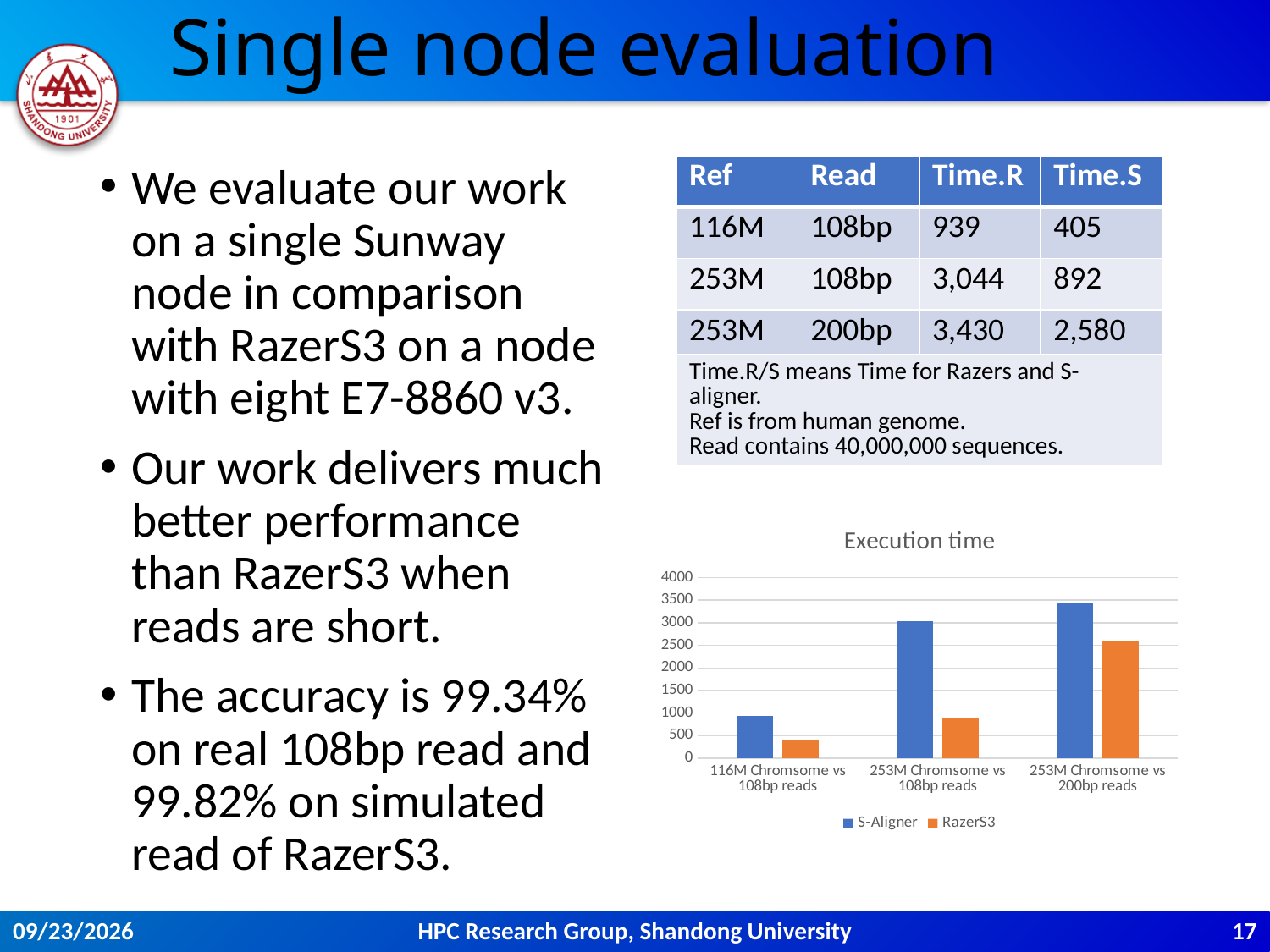
How many categories are shown on the x axis of the chart? 3 How many series does the chart legend list? 2 Do the S-Aligner values rise or fall from left to right along the x axis? rise What is the title of the chart? Execution time Which category has the highest S-Aligner value? 253M Chromsome vs 200bp reads Is the RazerS3 value for 253M Chromsome vs 108bp reads greater or less than 1000? less Is the S-Aligner value for 253M Chromsome vs 200bp reads greater or less than 3000? greater Is the S-Aligner value for 116M Chromsome vs 108bp reads greater or less than 500? greater For 253M Chromsome vs 200bp reads, which series has the larger value, S-Aligner or RazerS3? S-Aligner Which colour represents RazerS3 in the chart? orange What type of chart is shown on the slide? bar chart